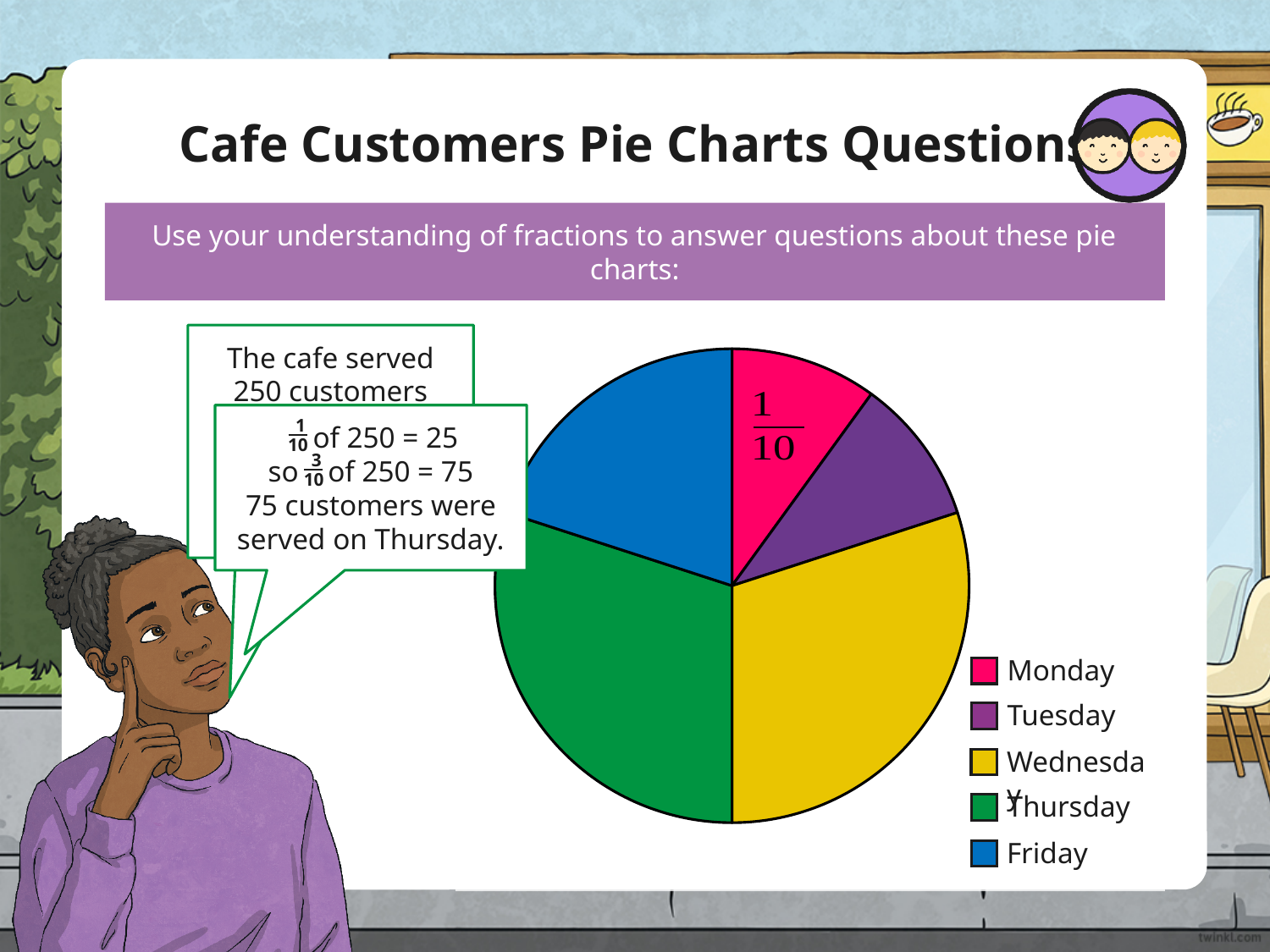
What colour is the Friday slice in the pie chart? blue How many slices does the pie chart have? 5 How many entries does the legend list? 5 What fraction of the pie chart is the Monday slice? 1/10 Which slice is larger, Thursday or Monday? Thursday What kind of chart is shown on the slide? pie chart Which slice is larger, Wednesday or Monday? Wednesday Which day is shown in green in the legend? Thursday How many customers were served on Thursday? 75 How many customers did the cafe serve in total? 250 What fraction of the pie chart is the Thursday slice? 3/10